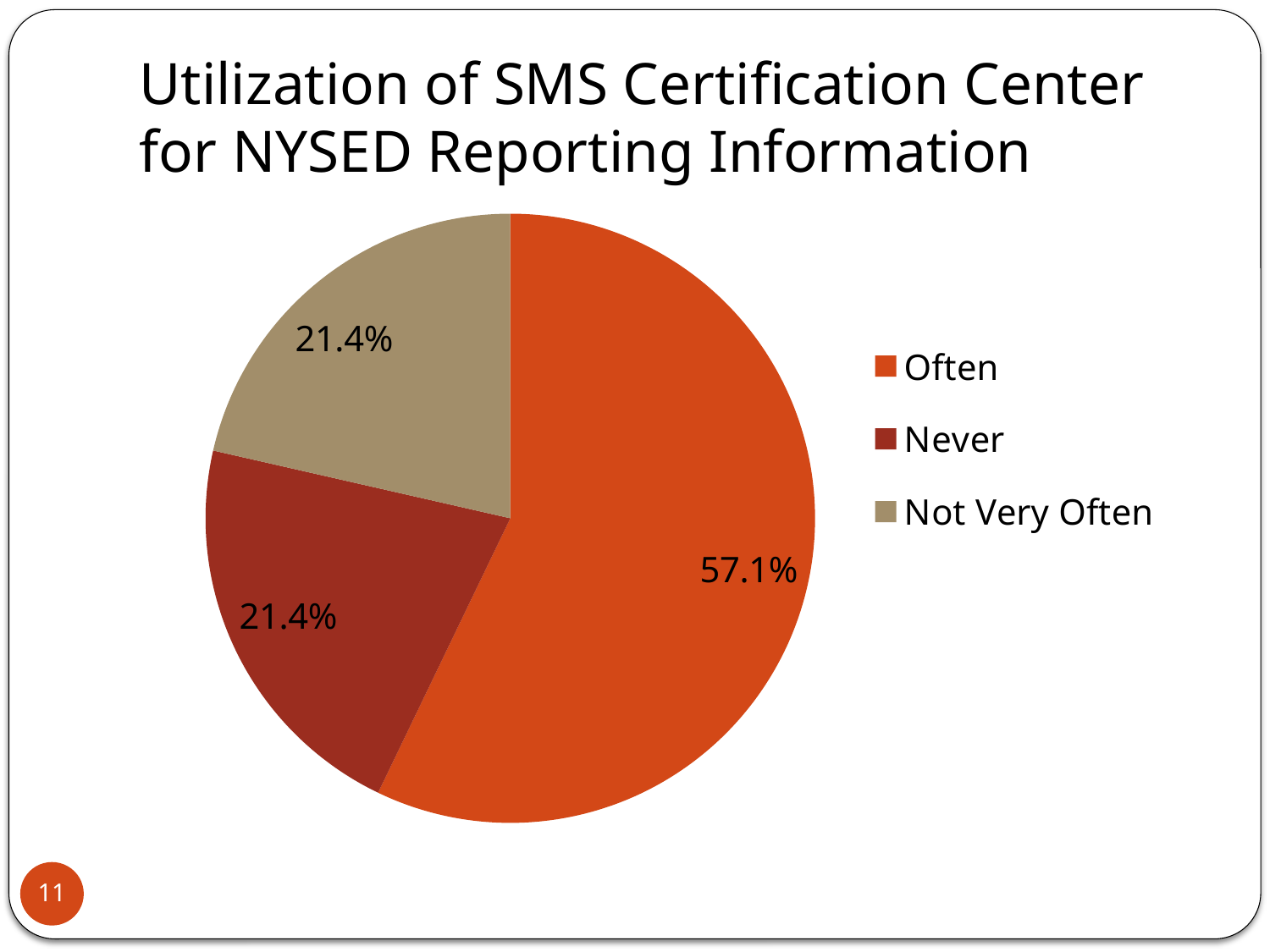
What is the title of the slide containing the pie chart? Utilization of SMS Certification Center for NYSED Reporting Information What share of the pie does the Often slice represent? 57.1% How many slices does the pie chart have? 3 What kind of chart is shown on the slide? pie chart Is the share for Often greater or less than 50%? greater How many entries does the legend list? 3 What share of the pie does the Never slice represent? 21.4% Which is larger, the Often slice or the Never slice? Often Which category has the largest slice of the pie? Often What colour is the Never slice in the pie chart? dark red What is the difference between the Often share and the Not Very Often share? 35.7% What share of the pie does the Not Very Often slice represent? 21.4%